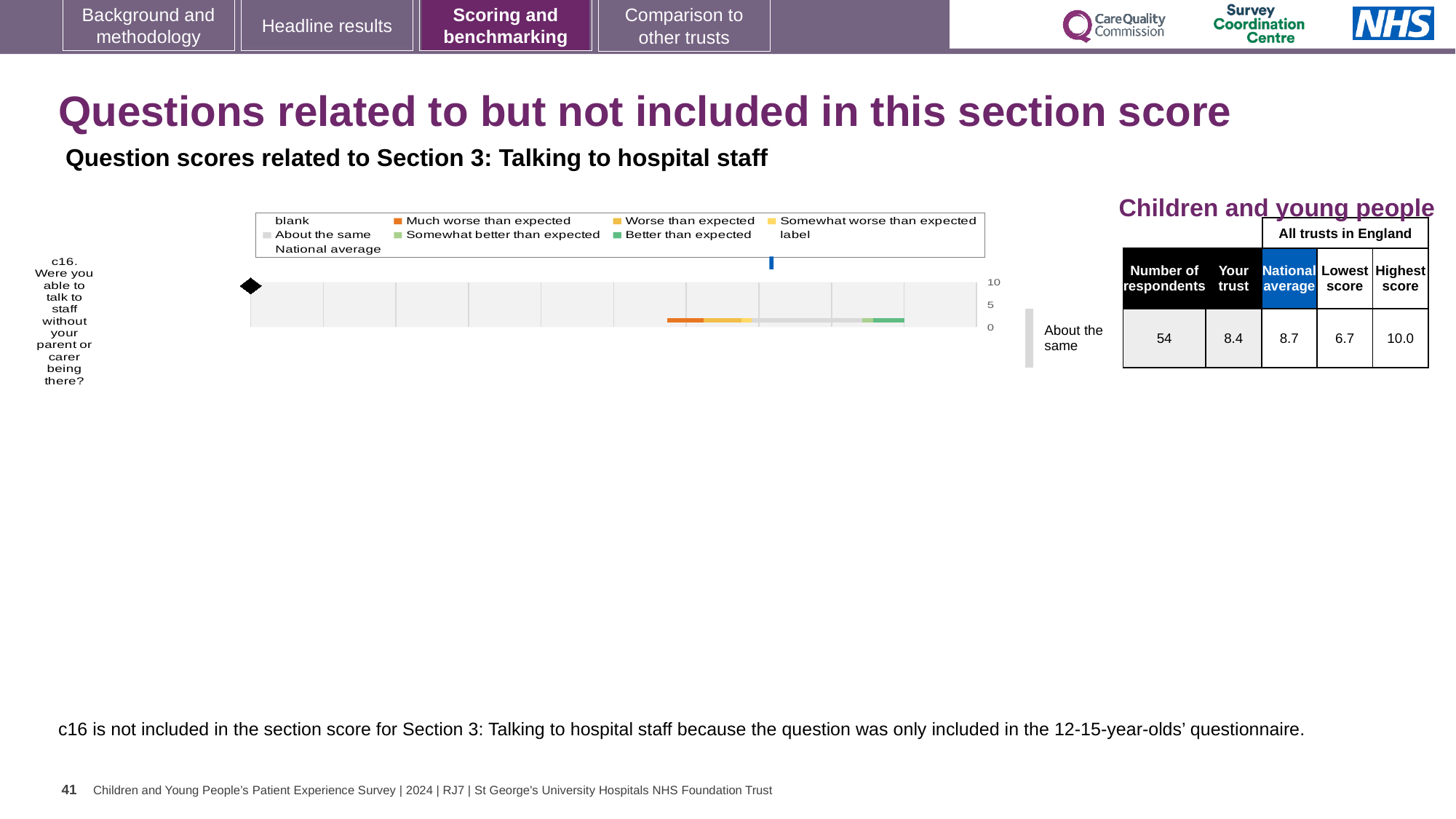
In the table beside the chart, what is the highest score among all trusts in England for c16? 10.0 How many survey questions are plotted on the chart? 1 Which question is plotted on the chart? c16. Were you able to talk to staff without your parent or carer being there? What is the highest value shown on the chart's axis? 10 In the table beside the chart, what is the number of respondents for c16? 54 What category label is shown to the right of the chart for c16? About the same In the table beside the chart, what is the National average score for c16? 8.7 In the table beside the chart, what is the 'Your trust' score for c16? 8.4 In the table beside the chart, what is the lowest score among all trusts in England for c16? 6.7 In the table beside the chart, which is larger for c16: the 'Your trust' score or the National average? National average In the table beside the chart, what is the difference between the highest score and the lowest score for c16? 3.3 What kind of chart is shown on the slide? bar chart